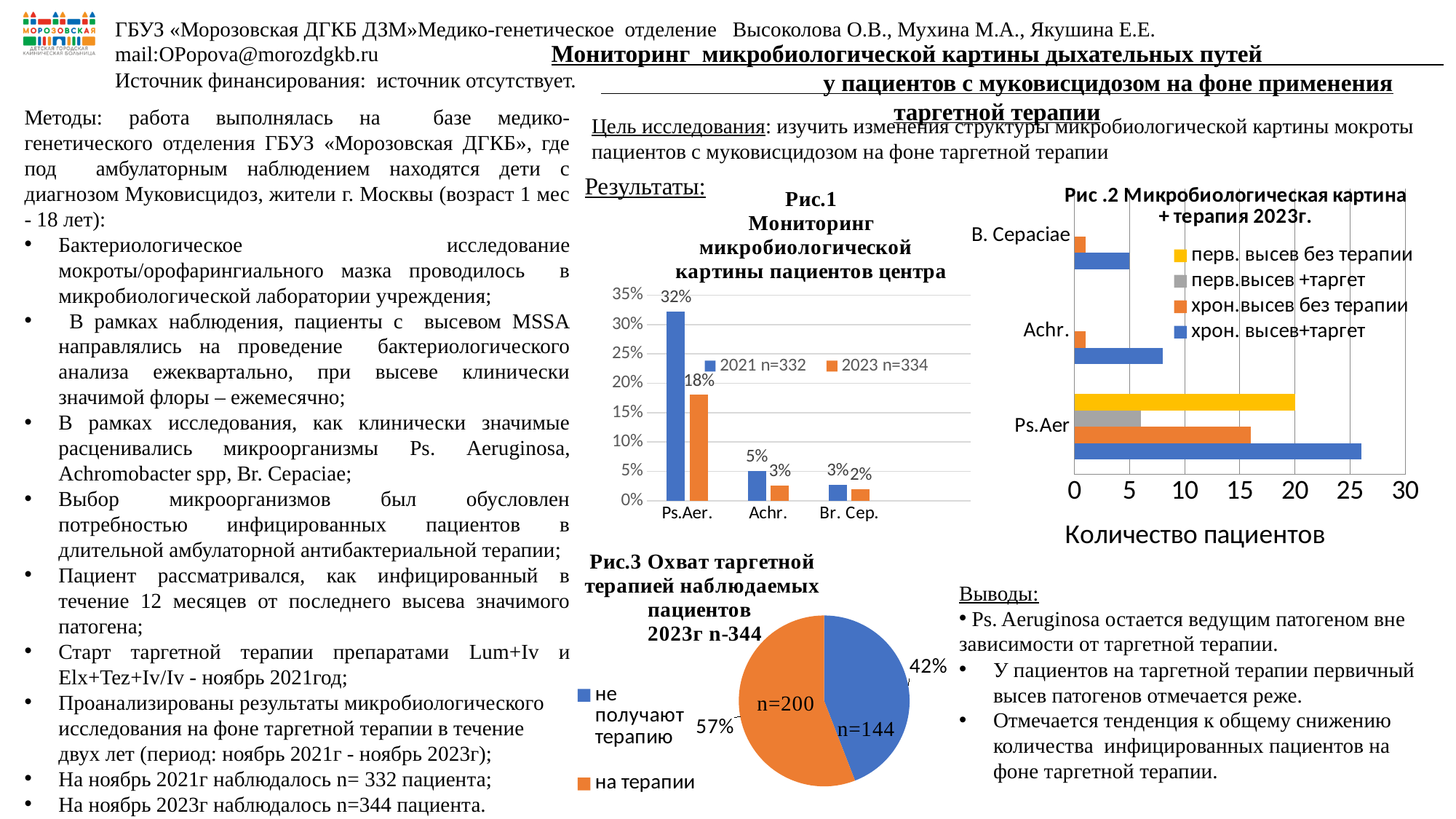
In Рис.1, what is the value for Ps.Aer. in the 2021 n=332 series? 32% In Рис.1, what is the difference between the 2021 and 2023 values for Ps.Aer.? 14% In Рис.1, which is larger for Br. Cep.: the 2021 value or the 2023 value? 2021 In Рис.1, what is the value for Achr. in the 2023 n=334 series? 3% In Рис.1, which category has the highest value in the 2021 n=332 series? Ps.Aer. In Рис.2, what is the title of the horizontal axis? Количество пациентов In Рис.3, what share of the pie is на терапии? 57% In Рис.2, is the value of хрон.высев без терапии for Ps.Aer greater or less than 10? greater In Рис.2, how many series does the legend list? 4 In Рис.1, how many series does the legend list? 2 What kind of chart is Рис.1? Bar chart In Рис.2, is the value of хрон. высев+таргет for Ps.Aer greater or less than 20? greater